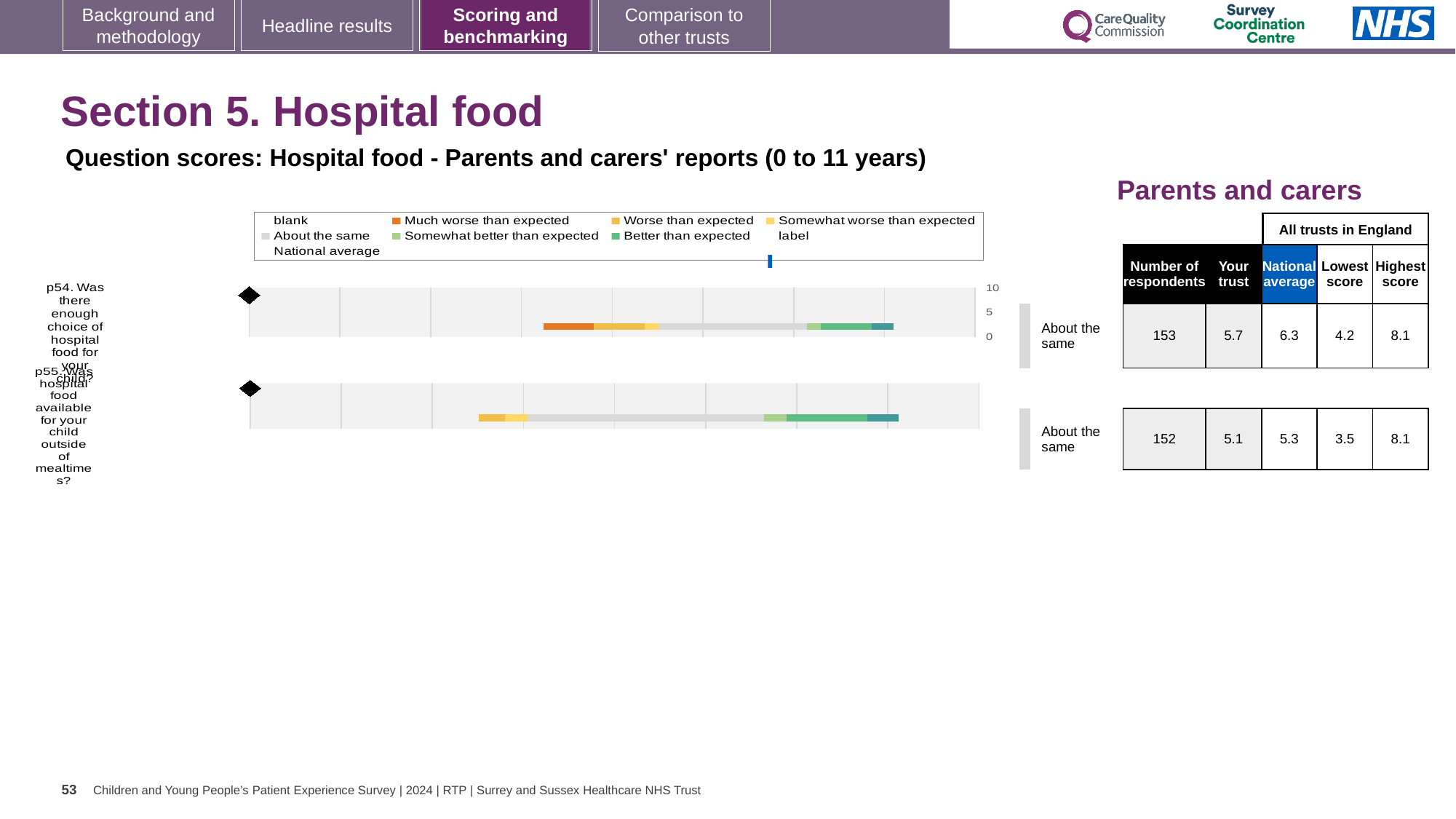
How many respondents answered p54? 153 What kind of chart is shown on the slide? bar chart What is the national average score for p55 (hospital food available outside of mealtimes)? 5.3 Which question has the higher 'Your trust' score, p54 or p55? p54 What is the difference between the highest score and the lowest score for p54? 3.9 How many entries does the chart legend list? 9 What is the 'Your trust' score for p54 (enough choice of hospital food)? 5.7 What colour represents 'Much worse than expected' in the chart legend? orange What benchmark category is shown for p55? About the same What is the lowest score across all trusts in England for p55? 3.5 How many questions (categories) are plotted in the chart? 2 What colour represents 'About the same' in the chart legend? grey